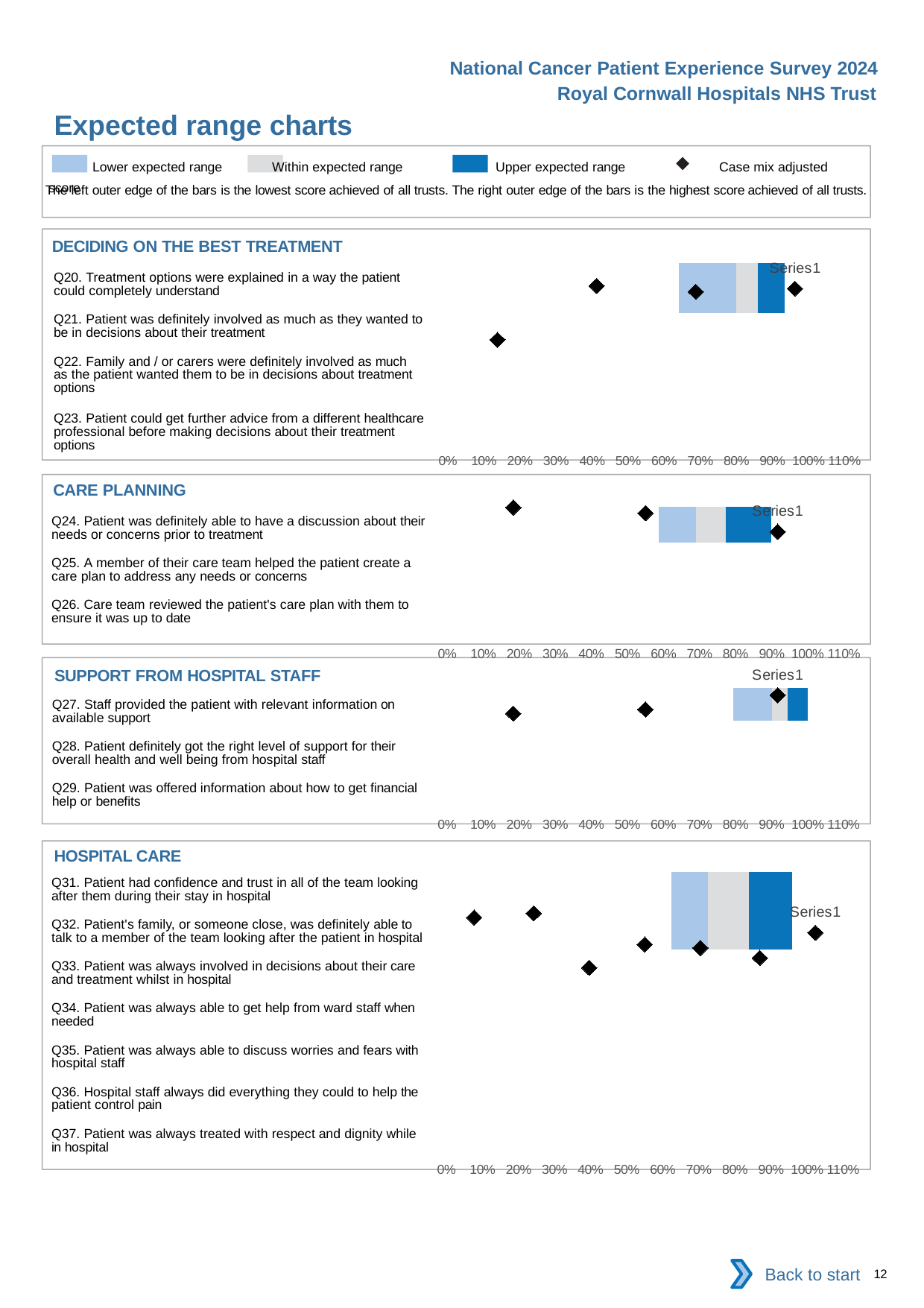
How many questions (categories) are listed in the HOSPITAL CARE chart? 7 According to the legend, what does the dark blue colour represent? Upper expected range What kind of chart is used in the DECIDING ON THE BEST TREATMENT section? Bar chart How many entries does the legend at the top of the slide list? 4 How many questions (categories) are listed in the CARE PLANNING chart? 3 What is the highest tick label shown on the x axis of the HOSPITAL CARE chart? 110% How many questions (categories) are listed in the DECIDING ON THE BEST TREATMENT chart? 4 In the CARE PLANNING chart, is the rightmost case mix adjusted score marker greater or less than 80%? greater In the HOSPITAL CARE chart, is the leftmost case mix adjusted score marker greater or less than 20%? less